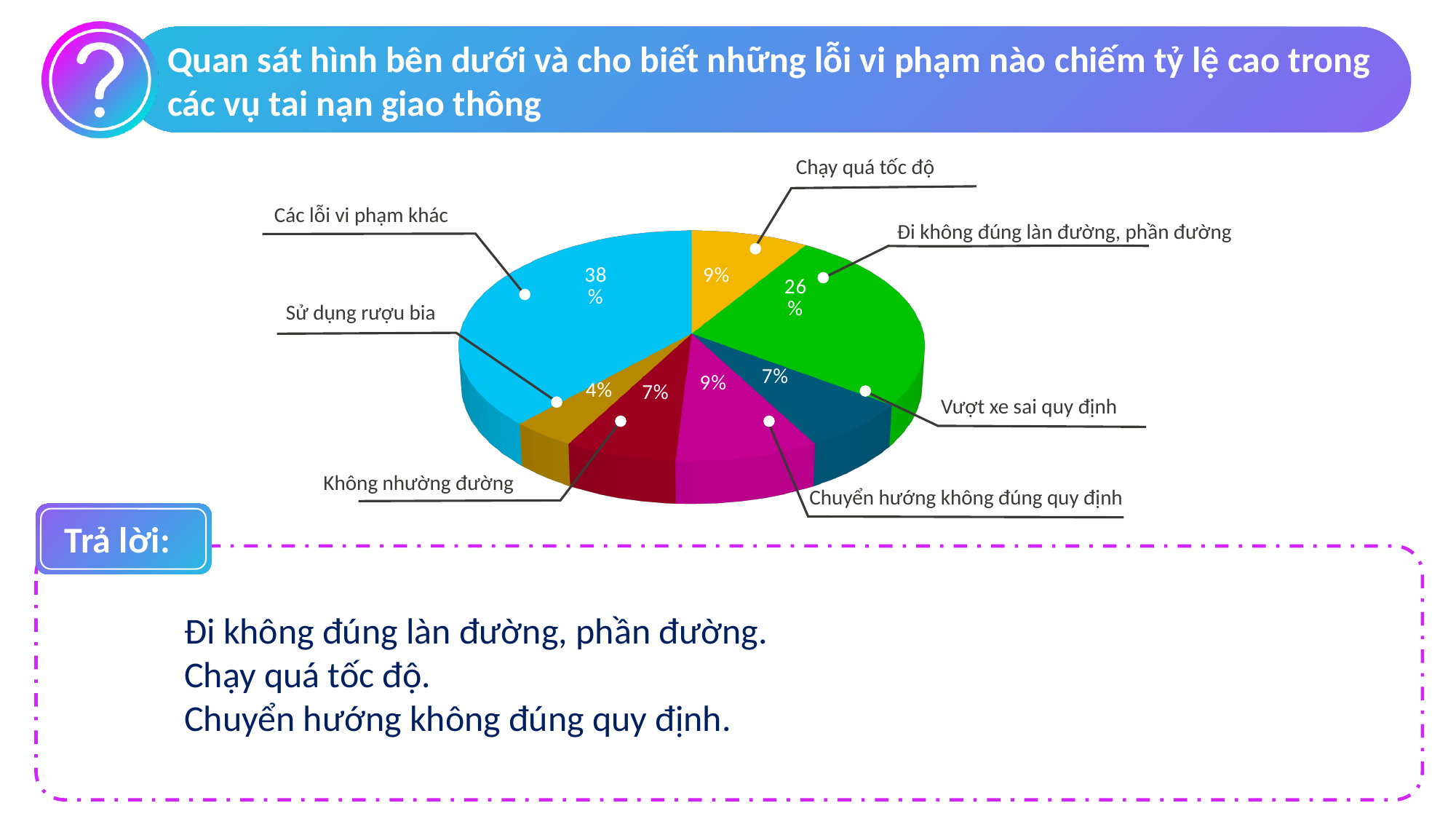
What kind of chart is shown on the slide? pie chart Which slice of the pie chart is the largest? Các lỗi vi phạm khác Which slice of the pie chart is the smallest? Sử dụng rượu bia How many slices does the pie chart have? 7 What percentage is shown for "Vượt xe sai quy định"? 7% What percentage is shown for "Đi không đúng làn đường, phần đường"? 26% Which is larger, the share for "Chuyển hướng không đúng quy định" or the share for "Không nhường đường"? Chuyển hướng không đúng quy định What is the difference in percentage points between "Các lỗi vi phạm khác" and "Đi không đúng làn đường, phần đường"? 12 What percentage is shown for "Sử dụng rượu bia"? 4% What colour is the slice for "Đi không đúng làn đường, phần đường"? green What percentage is shown for "Chạy quá tốc độ"? 9% What percentage is shown for "Các lỗi vi phạm khác"? 38%